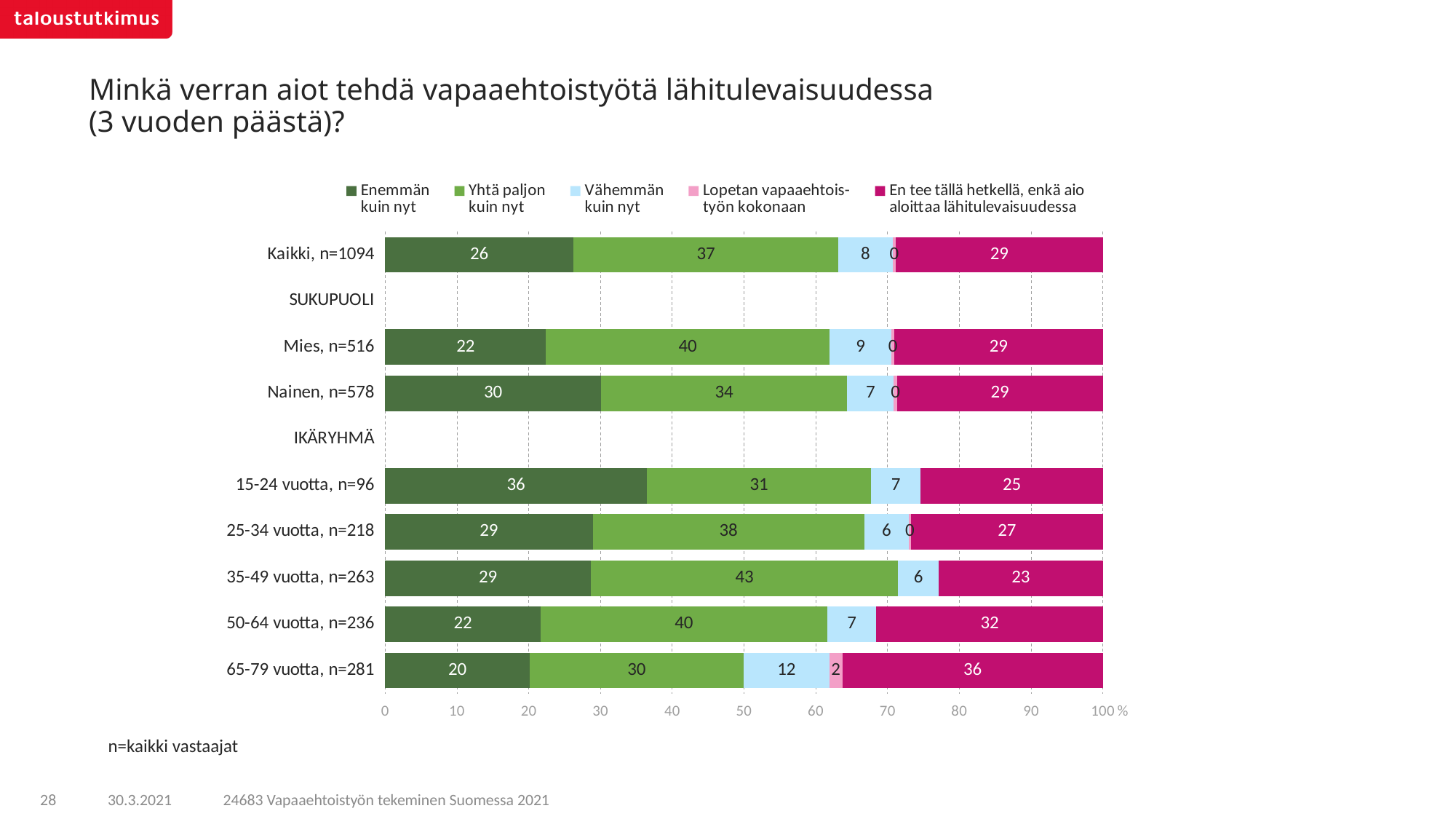
What is the value of "Yhtä paljon kuin nyt" for 35-49 vuotta, n=263? 43 Which group has the highest value for "Enemmän kuin nyt"? 15-24 vuotta, n=96 Which group has the lowest value for "En tee tällä hetkellä, enkä aio aloittaa lähitulevaisuudessa"? 35-49 vuotta, n=263 What is the value of "Vähemmän kuin nyt" for 65-79 vuotta, n=281? 12 How many series does the legend list? 5 What is the value of "En tee tällä hetkellä, enkä aio aloittaa lähitulevaisuudessa" for 50-64 vuotta, n=236? 32 What is the difference between the "Enemmän kuin nyt" values for Nainen, n=578 and Mies, n=516? 8 What is the value of "Enemmän kuin nyt" for Kaikki, n=1094? 26 What kind of chart is shown on the slide? Stacked bar chart How many respondent groups (bars) are plotted in the chart? 8 What is the value of "Lopetan vapaaehtoistyön kokonaan" for 65-79 vuotta, n=281? 2 Which has a larger "Yhtä paljon kuin nyt" value, Mies, n=516 or Nainen, n=578? Mies, n=516